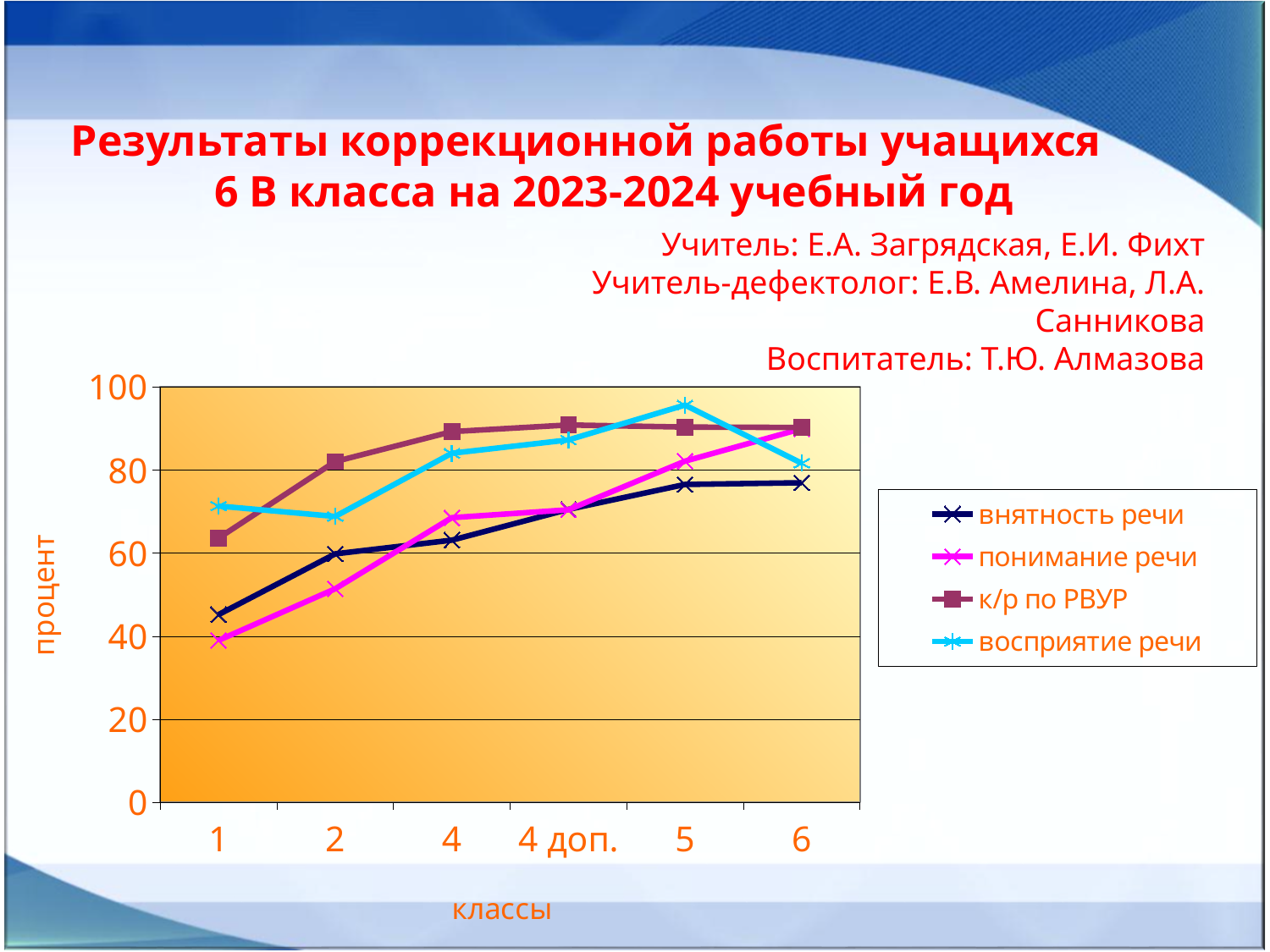
Does the внятность речи line generally rise or fall from class 1 to class 6? rise How many series does the legend list? 4 Which series has the lowest value at class 1? понимание речи Is the value for восприятие речи at class 1 greater or less than 80? less What kind of chart is shown on the slide? line chart Is the value for к/р по РВУР at class 4 greater or less than 80? greater Is the value for понимание речи at class 2 greater or less than 60? less At class 2, which is larger: внятность речи or к/р по РВУР? к/р по РВУР How many categories are shown on the x axis? 6 Which series has the highest value at class 1? восприятие речи What is the title of the vertical axis? процент